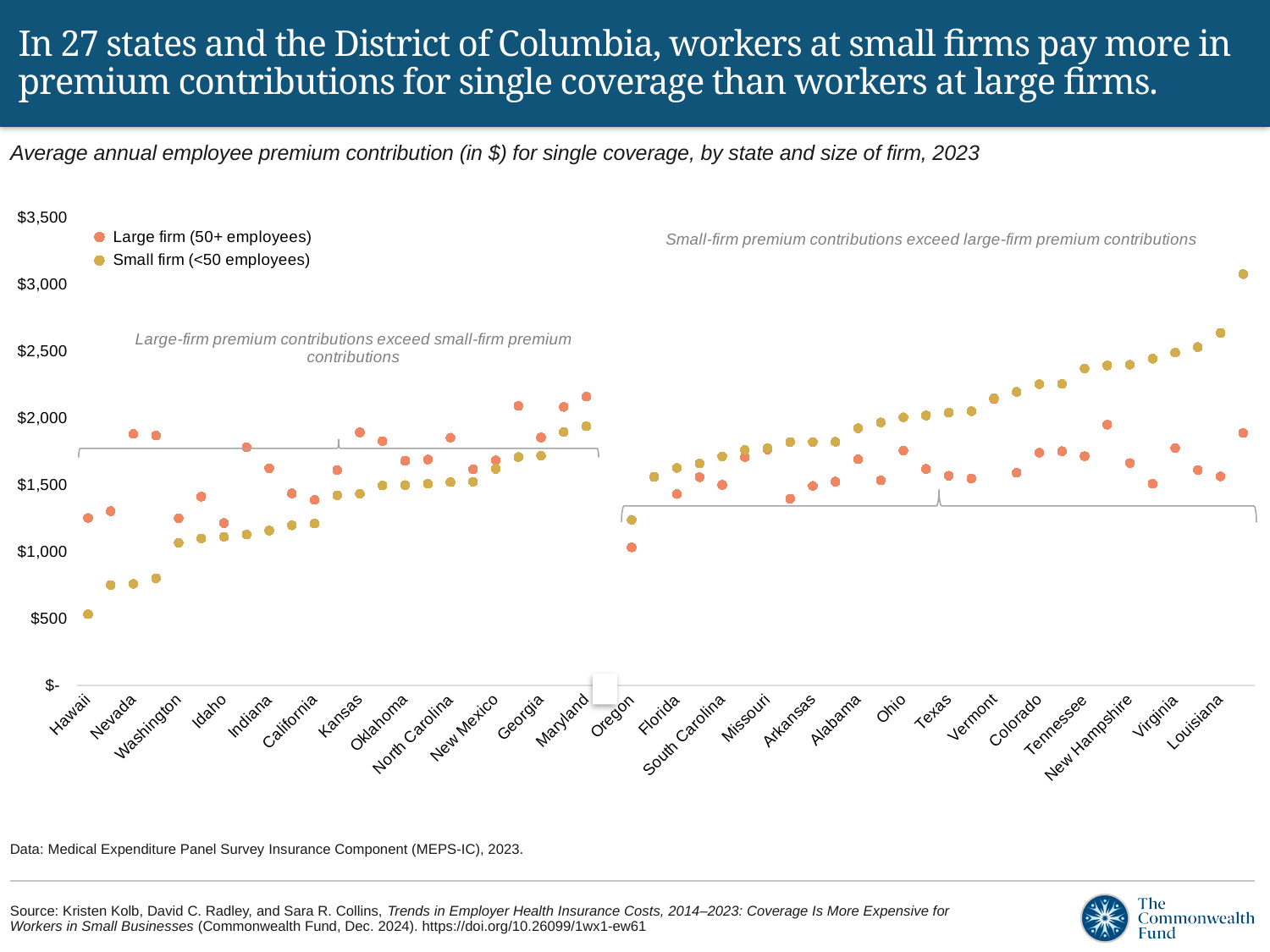
Is the small-firm premium contribution for Louisiana greater or less than $3,000? less What colour are the markers for the small-firm series? Yellow (gold) For Louisiana, which is larger: the large-firm or the small-firm premium contribution? Small firm Which state has the lowest small-firm premium contribution? Hawaii Is the large-firm premium contribution for Maryland greater or less than $2,000? greater Is the large-firm premium contribution for Louisiana greater or less than $2,000? less What kind of chart is shown on the slide? Scatter (dot) chart For Hawaii, which is larger: the large-firm or the small-firm premium contribution? Large firm How many series does the legend list? 2